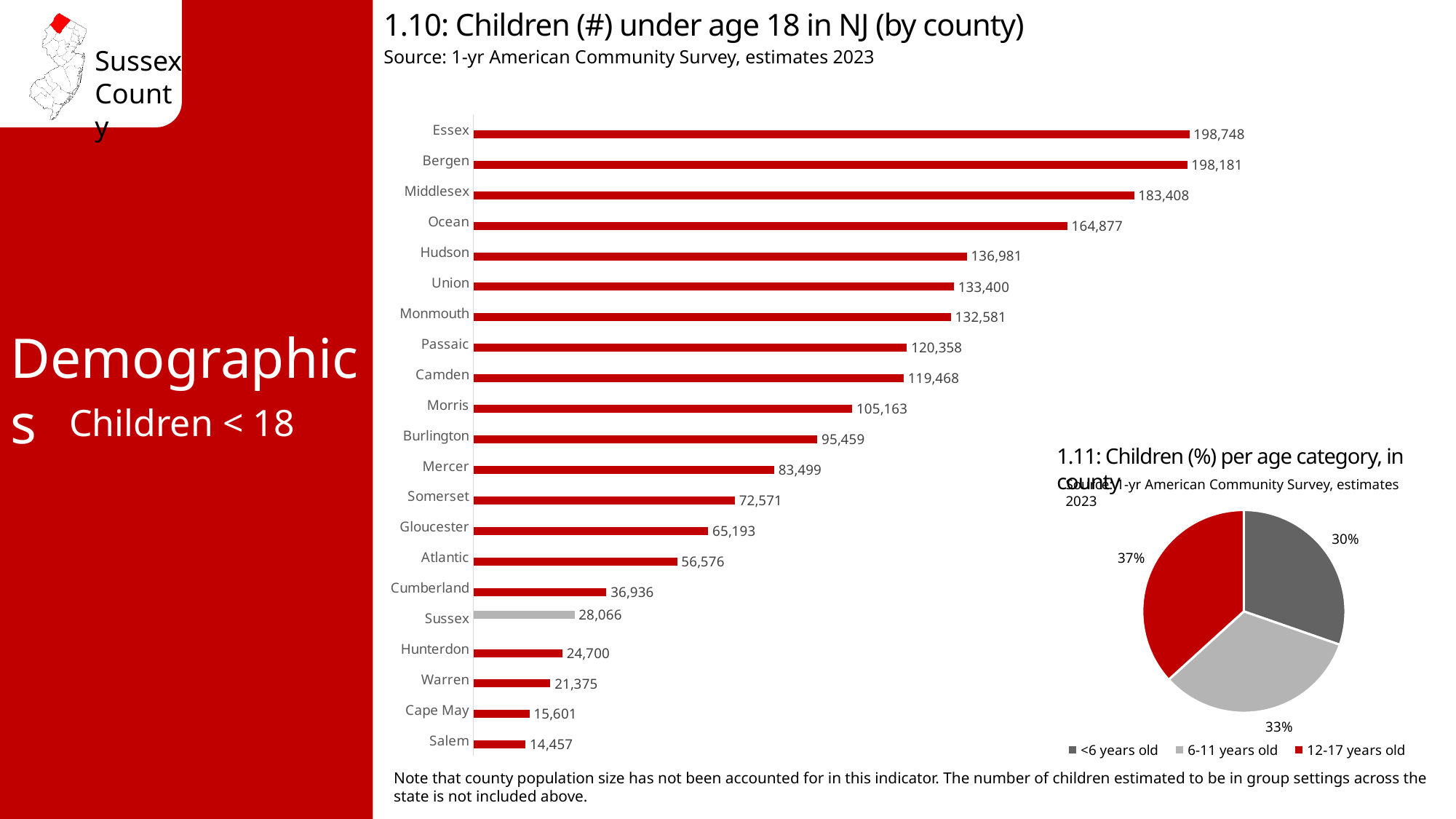
In chart 1.10, which bar is coloured grey instead of red? Sussex How many categories does the legend of chart 1.11 list? 3 In chart 1.10 (Children under age 18 in NJ by county), what is the value for Sussex? 28,066 In chart 1.10, how many counties are shown? 21 In chart 1.10, what is the difference between the values for Essex and Bergen? 567 In chart 1.11, which age category has the largest share? 12-17 years old In chart 1.10, what is the value for Hudson? 136,981 In chart 1.10, which county has the lowest number of children under 18? Salem In chart 1.11 (Children (%) per age category, in county), what share of children are 6-11 years old? 33% In chart 1.10, which has more children under 18, Morris or Burlington? Morris What type of chart is chart 1.10? Bar chart In chart 1.10, which county has the highest number of children under 18? Essex